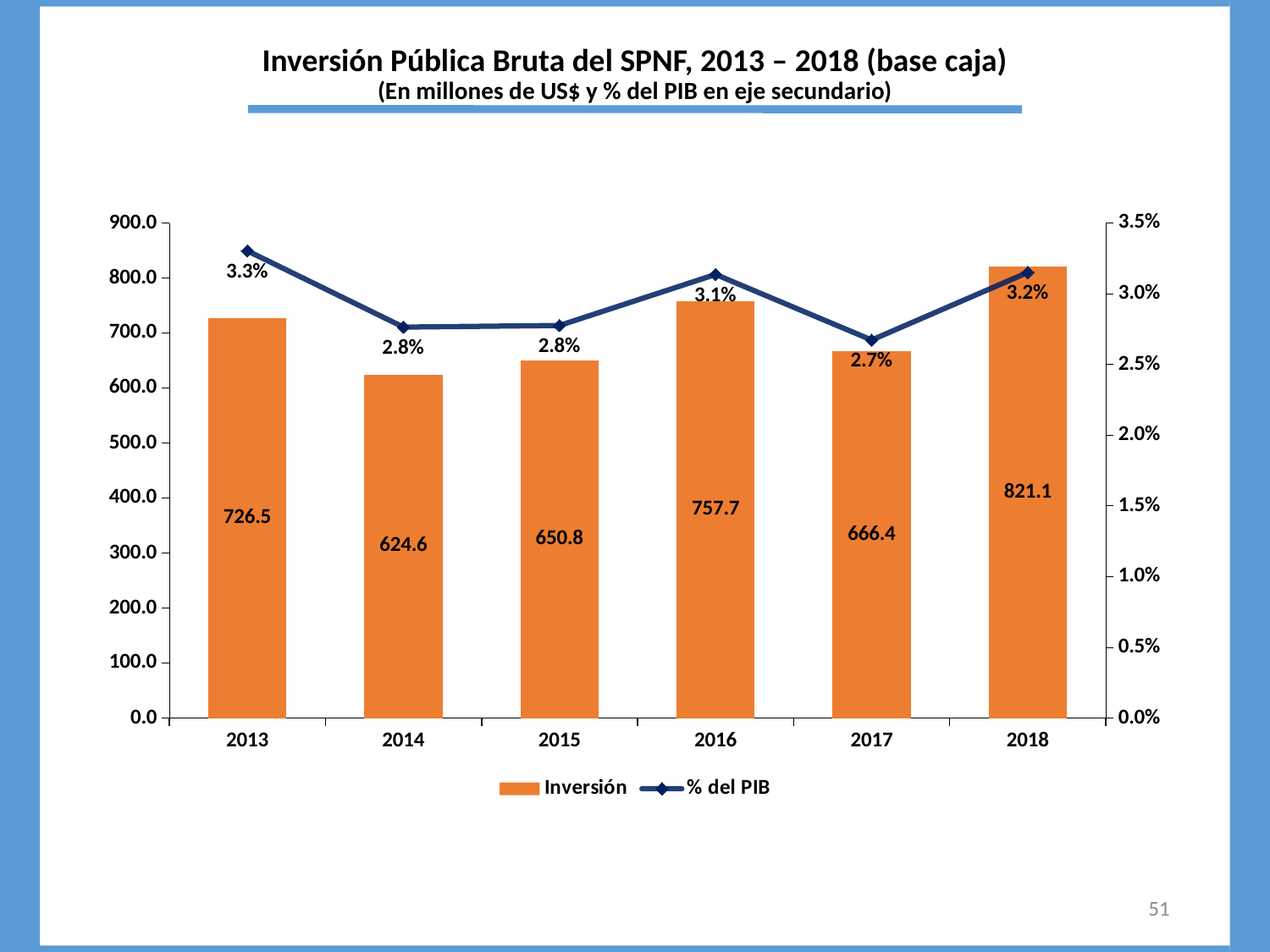
How many years are shown on the x axis? 6 Is the Inversión value for 2015 greater or less than 700.0? less What is the % del PIB value for 2013? 3.3% What is the Inversión value for 2016? 757.7 Does the Inversión value rise or fall from 2017 to 2018? rise Which year has the lowest Inversión value? 2014 How many series does the legend list? 2 Which is larger, the Inversión value for 2013 or for 2017? 2013 Which year has the highest Inversión value? 2018 What kind of chart is used for the Inversión series? bar chart Which year has the lowest % del PIB value? 2017 What is the difference between the Inversión values for 2018 and 2014? 196.5